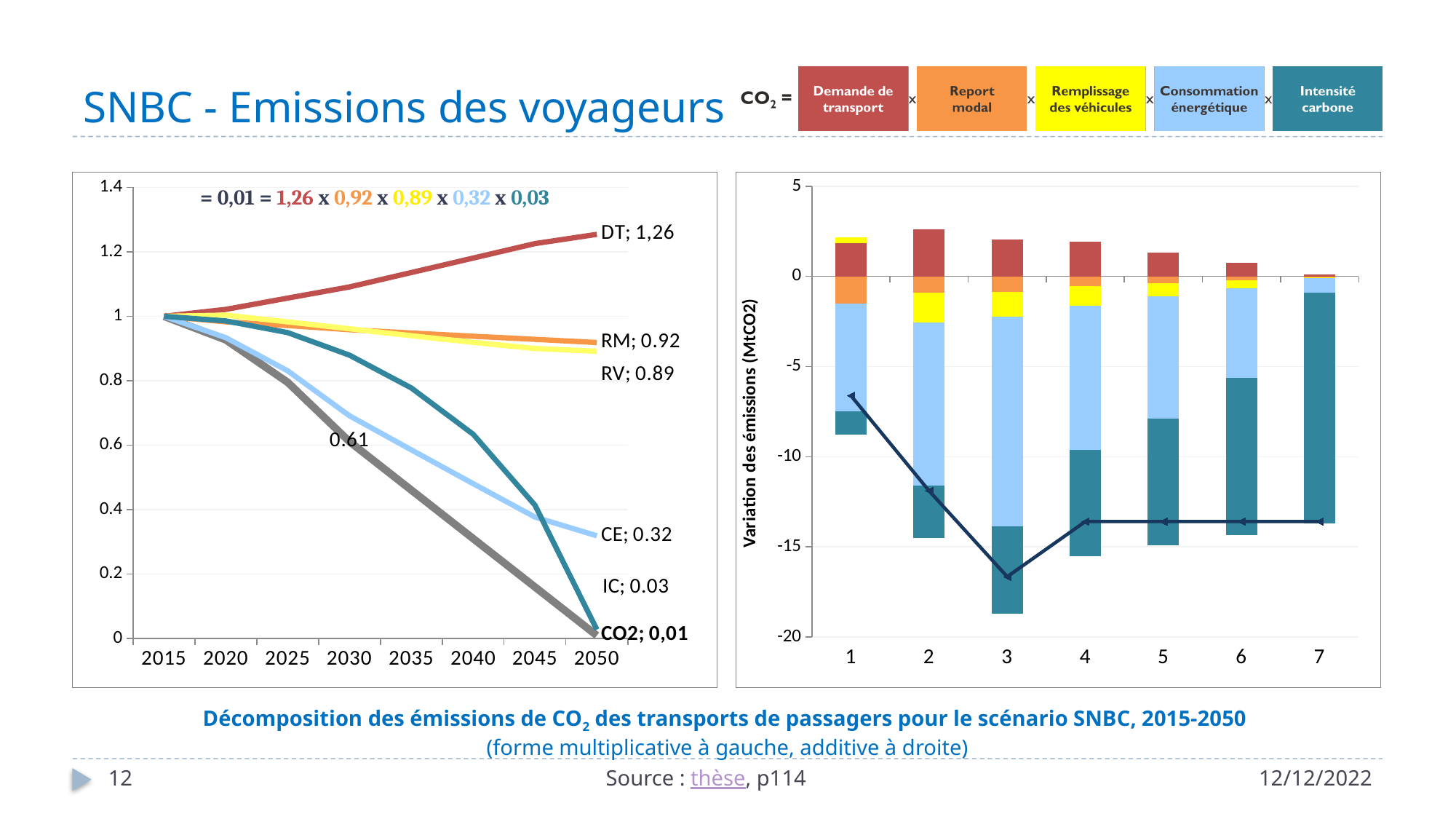
In the right chart, how many categories are shown on the x axis? 7 In the left chart, which series has the highest value in 2050? DT In the right chart, is the value of the dark line at category 3 greater or less than -15? less What kind of chart is the left chart (forme multiplicative)? line chart In the left chart, what is the value of CE in 2050? 0.32 In the left chart, what is the value of CO2 in 2050? 0,01 In the left chart, which series has the lowest value in 2050? CO2 In the left chart, what is the difference between the 2050 values of DT and CE? 0,94 In the left chart, does the DT series rise or fall from 2015 to 2050? rise In the left chart, which is larger in 2050, RM or RV? RM What kind of chart is the right chart (forme additive)? combination bar and line chart (stacked bars with a line) In the left chart, what is the value of DT in 2050? 1,26